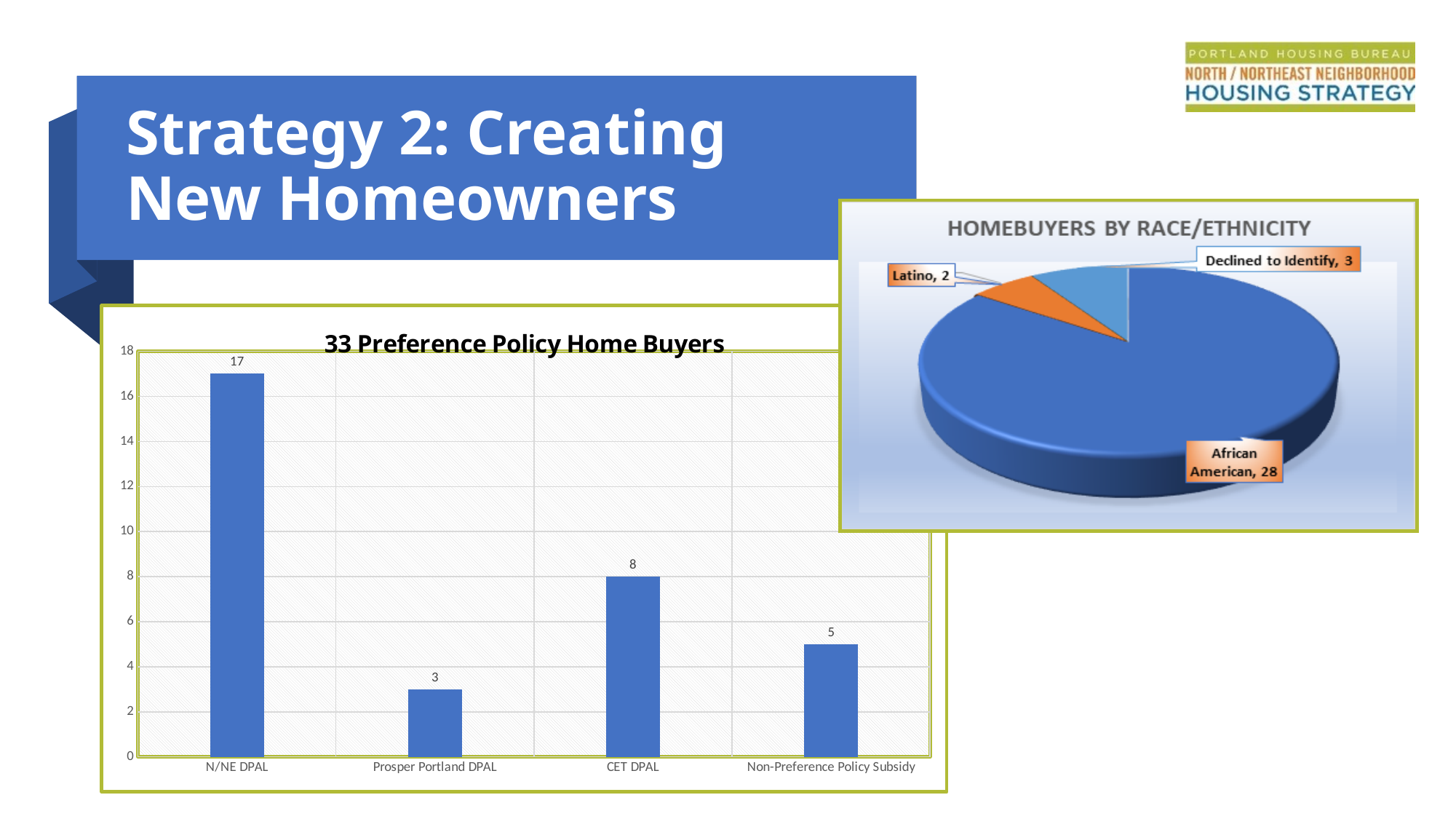
What kind of chart is the 'Homebuyers by Race/Ethnicity' chart? pie chart In the '33 Preference Policy Home Buyers' chart, what is the value for CET DPAL? 8 In the 'Homebuyers by Race/Ethnicity' chart, which category has the largest slice? African American In the '33 Preference Policy Home Buyers' chart, which is larger: CET DPAL or Non-Preference Policy Subsidy? CET DPAL In the 'Homebuyers by Race/Ethnicity' chart, what is the value for African American? 28 In the '33 Preference Policy Home Buyers' chart, what is the value for N/NE DPAL? 17 In the 'Homebuyers by Race/Ethnicity' chart, what is the value for Latino? 2 In the '33 Preference Policy Home Buyers' chart, what is the difference between N/NE DPAL and CET DPAL? 9 What kind of chart is the '33 Preference Policy Home Buyers' chart? bar chart How many categories are shown in the '33 Preference Policy Home Buyers' chart? 4 In the '33 Preference Policy Home Buyers' chart, which category has the lowest value? Prosper Portland DPAL In the '33 Preference Policy Home Buyers' chart, which category has the highest value? N/NE DPAL